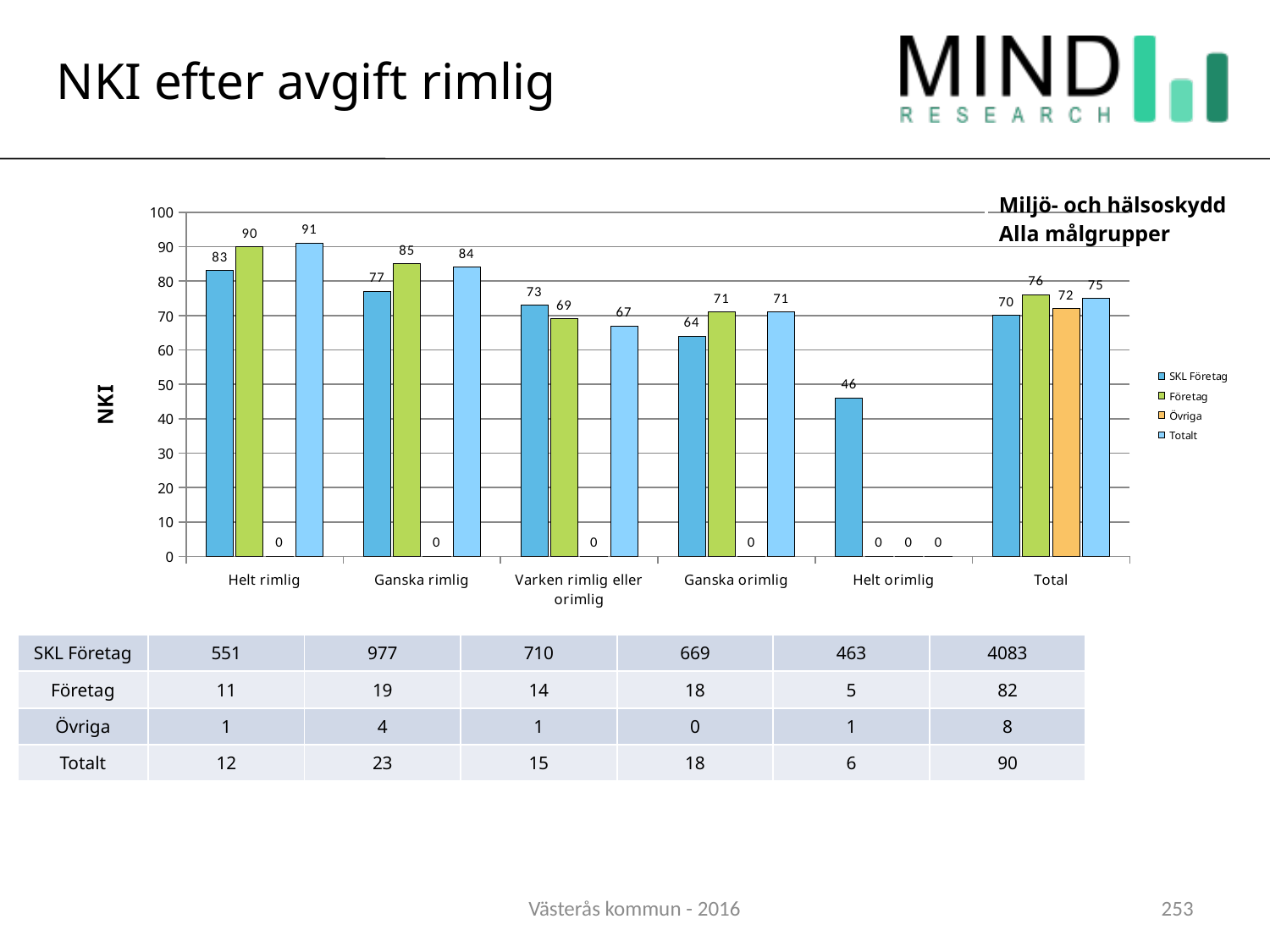
What is the NKI value for Övriga in the Total category? 72 Which category has the lowest NKI value for SKL Företag? Helt orimlig How many categories are shown on the x axis? 6 Which is larger in the Varken rimlig eller orimlig category: SKL Företag or Totalt? SKL Företag What is the NKI value for Företag in the Ganska rimlig category? 85 What is the NKI value for SKL Företag in the Helt rimlig category? 83 What is the NKI value for Totalt in the Helt rimlig category? 91 Which category has the highest NKI value for Företag? Helt rimlig What is the NKI value for SKL Företag in the Helt orimlig category? 46 How many series does the legend list? 4 What type of chart is shown on the slide? Bar chart What is the difference between the Företag and SKL Företag values in the Ganska rimlig category? 8